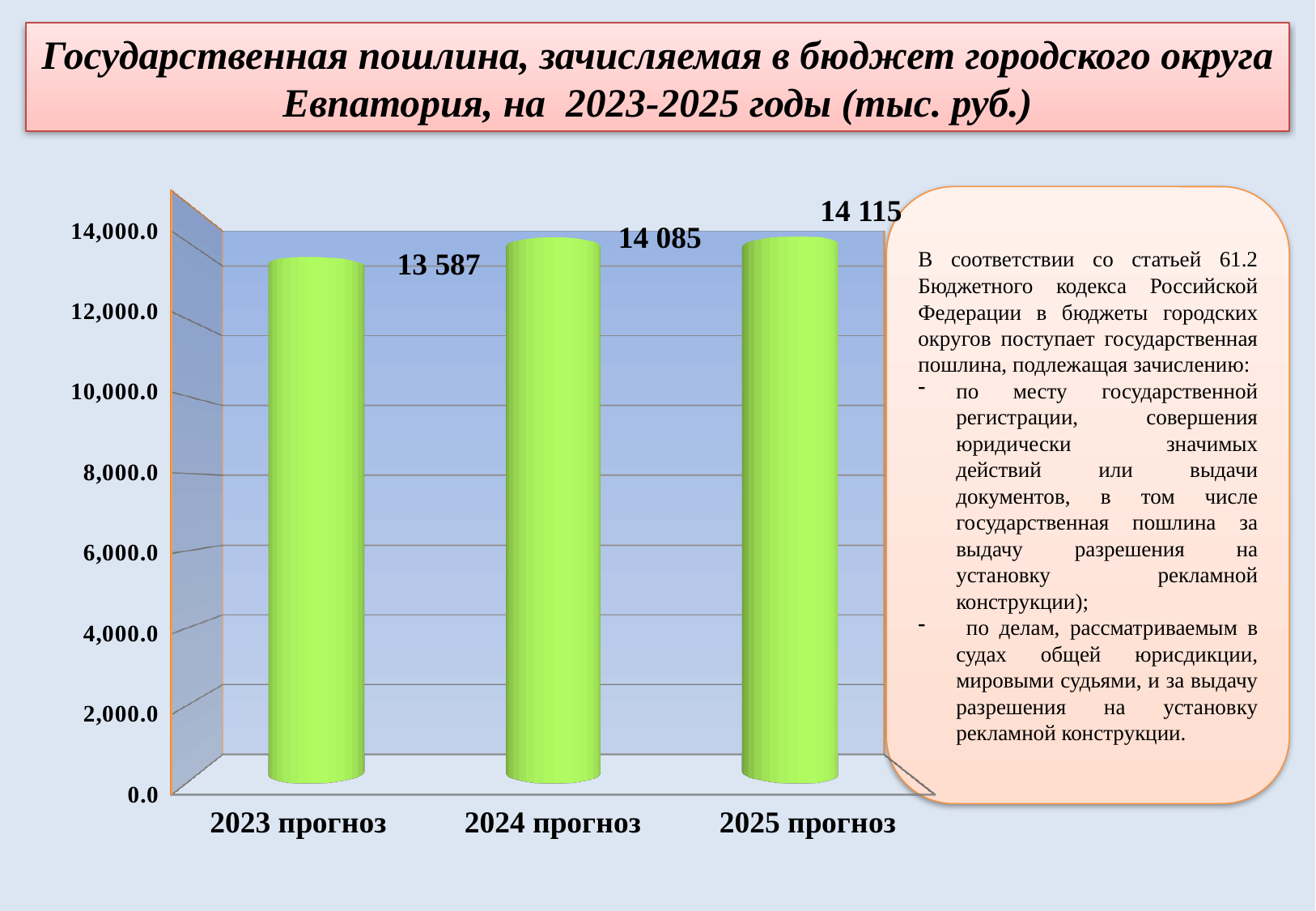
Which year has the highest value? 2025 прогноз Do the values rise or fall from 2023 прогноз to 2025 прогноз? rise Which year has the lowest value? 2023 прогноз What is the difference between the values for 2025 прогноз and 2024 прогноз? 30 What kind of chart is shown on the slide? bar chart What is the value for 2025 прогноз? 14 115 What is the value for 2024 прогноз? 14 085 How many categories are shown on the x axis? 3 Is the value for 2023 прогноз greater or less than 14,000.0? less What is the value for 2023 прогноз? 13 587 What is the difference between the values for 2024 прогноз and 2023 прогноз? 498 Which is larger, the value for 2023 прогноз or 2024 прогноз? 2024 прогноз